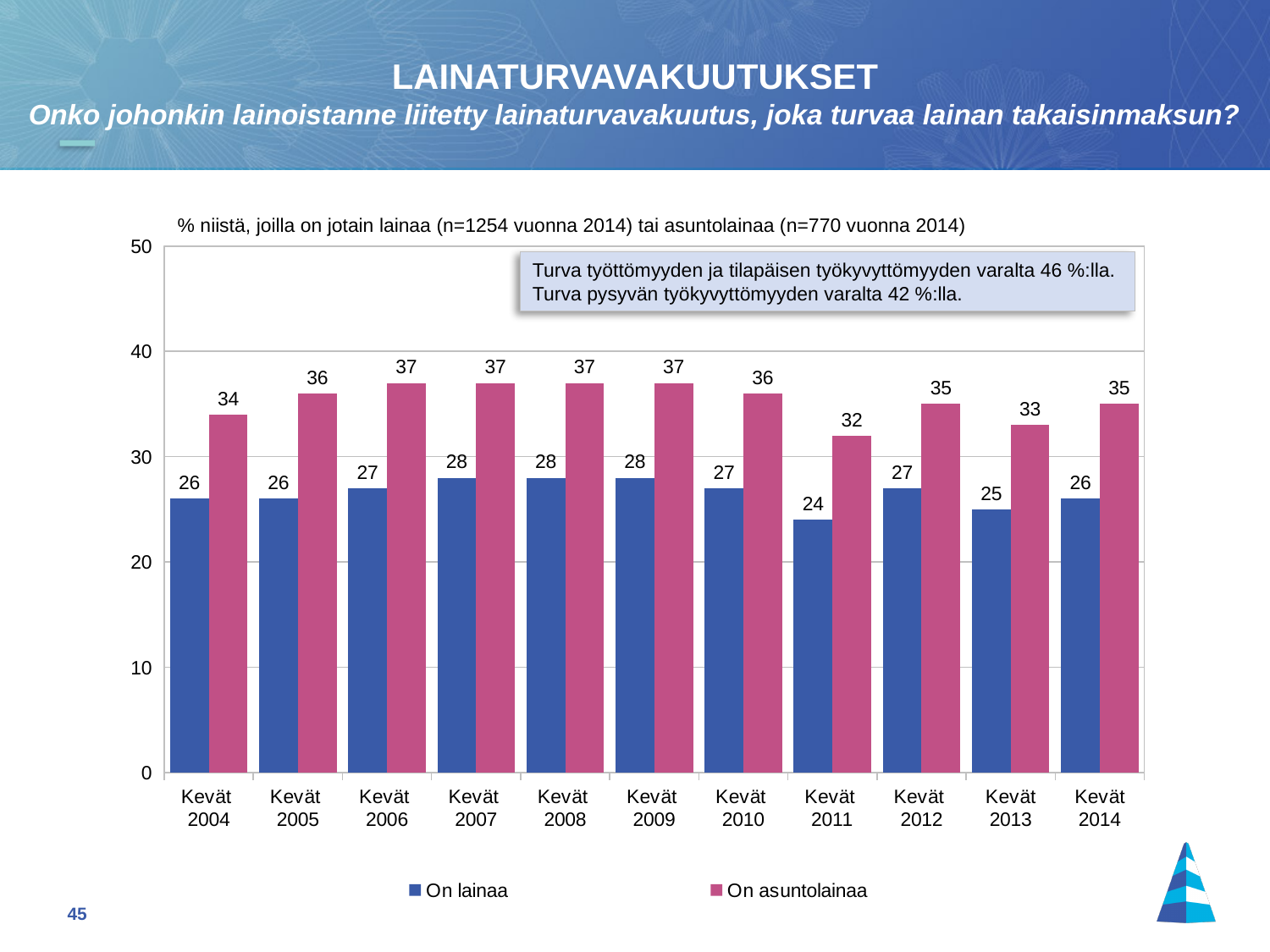
Is the value for "On asuntolainaa" in Kevät 2006 greater or less than 30? greater Which series is shown in pink/magenta bars? On asuntolainaa In which year is the "On lainaa" value lowest? Kevät 2011 What is the value for "On asuntolainaa" in Kevät 2004? 34 What kind of chart is shown on the slide? Bar chart Which is larger in Kevät 2012: "On lainaa" or "On asuntolainaa"? On asuntolainaa How many years (categories) are shown on the x axis? 11 In which year is the "On asuntolainaa" value lowest? Kevät 2011 What is the difference between "On asuntolainaa" and "On lainaa" in Kevät 2009? 9 How many series does the legend list? 2 What is the value for "On asuntolainaa" in Kevät 2014? 35 What is the value for "On lainaa" in Kevät 2011? 24